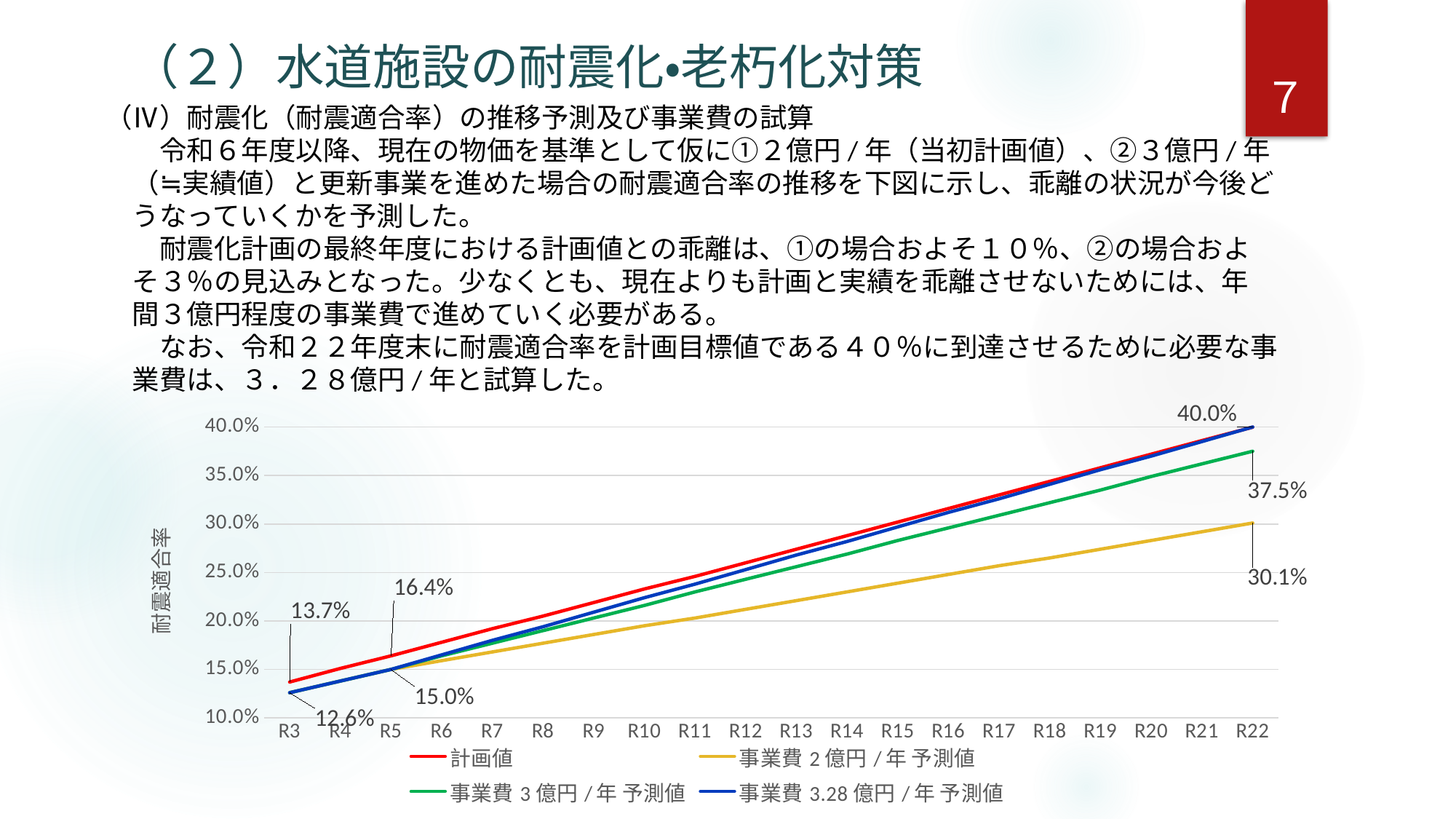
What is the value of 計画値 at R5? 16.4% What is the difference between 計画値 and 事業費 2 億円 / 年 予測値 at R22? 9.9% What is the value of 事業費 3 億円 / 年 予測値 at R22? 37.5% What is the value of 計画値 at R3? 13.7% What kind of chart is shown on the slide? line chart Is the value of 事業費 2 億円 / 年 予測値 at R12 greater or less than 25.0%? less How many series does the legend of the chart list? 4 How many fiscal-year categories are shown on the x axis of the chart? 20 What is the value of 事業費 2 億円 / 年 予測値 at R22? 30.1% Which series has the lowest value at R22? 事業費 2 億円 / 年 予測値 Do the values of the lines rise or fall from R3 to R22? rise What is the value of 計画値 at R22? 40.0%